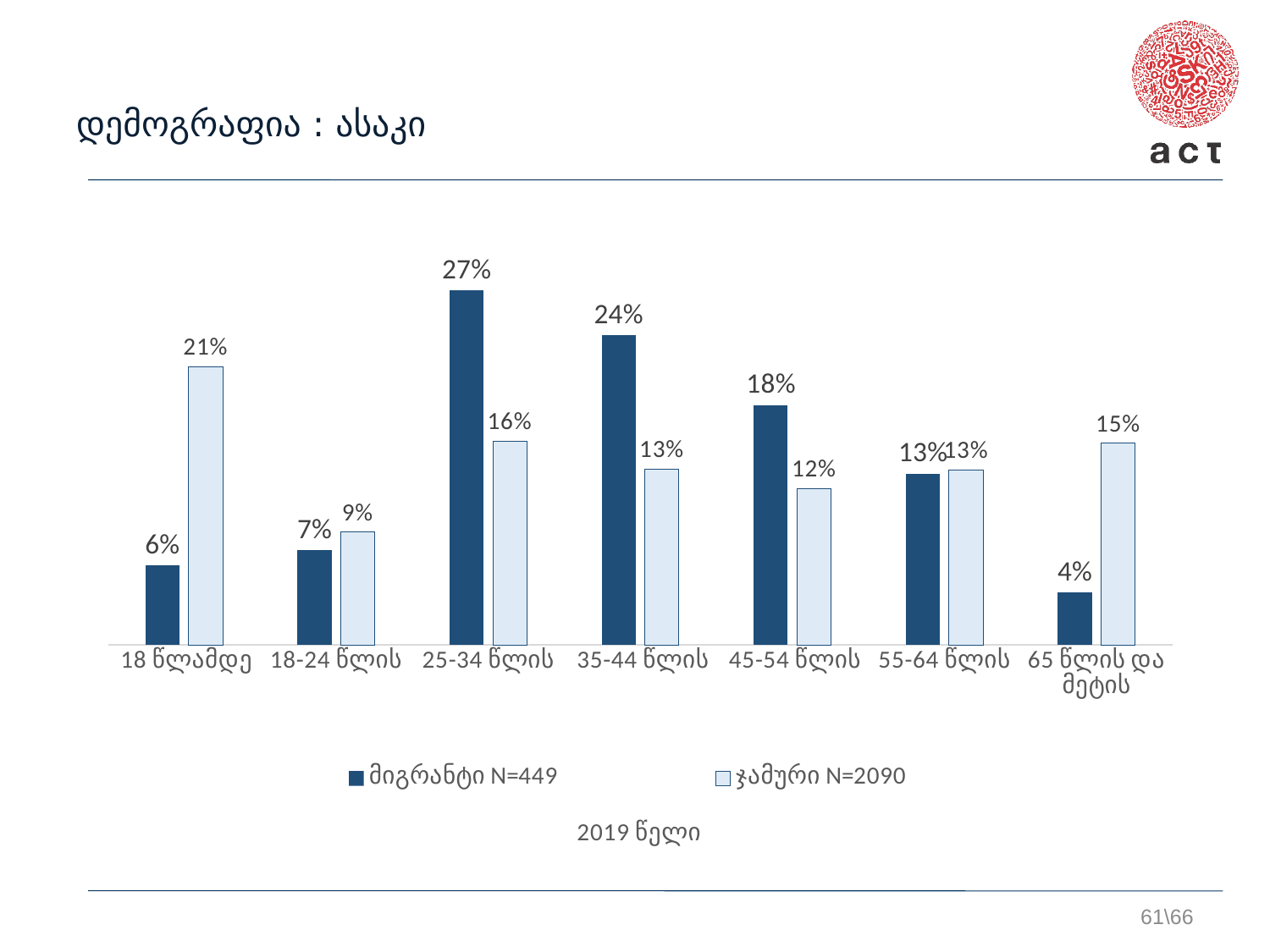
What is the value for მიგრანტი N=449 in the 65 წლის და მეტის category? 4% What is the value for ჯამური N=2090 in the 18 წლამდე category? 21% In the 18 წლამდე category, which series has the larger value, მიგრანტი N=449 or ჯამური N=2090? ჯამური N=2090 What is the value for მიგრანტი N=449 in the 25-34 წლის category? 27% Which age category has the highest value for მიგრანტი N=449? 25-34 წლის What year is indicated below the legend of the chart? 2019 წელი What type of chart is shown on the slide? bar chart How many age categories are shown on the x axis? 7 Which age category has the lowest value for ჯამური N=2090? 18-24 წლის What is the difference between მიგრანტი N=449 and ჯამური N=2090 in the 35-44 წლის category? 11% How many series does the legend list? 2 What is the value for ჯამური N=2090 in the 45-54 წლის category? 12%